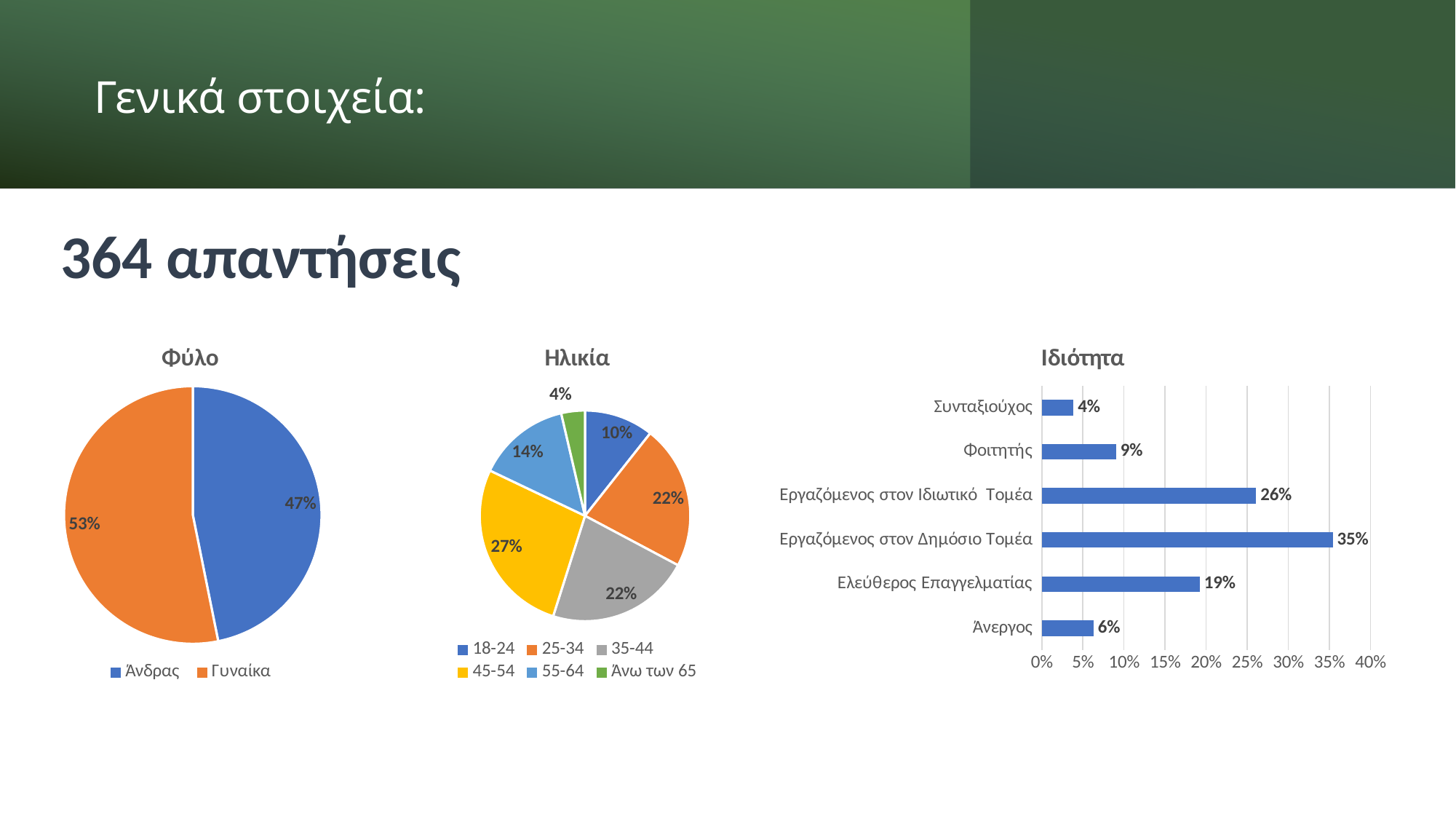
In the 'Φύλο' pie chart, which category has the larger share, Άνδρας or Γυναίκα? Γυναίκα In the 'Ιδιότητα' chart, what is the value for Εργαζόμενος στον Δημόσιο Τομέα? 35% In the 'Ηλικία' pie chart, which age group has the smallest share? Άνω των 65 In the 'Ιδιότητα' chart, how many categories are shown? 6 What kind of chart is the 'Ιδιότητα' chart? Bar chart In the 'Φύλο' pie chart, what share is labelled for Γυναίκα? 53% In the 'Ηλικία' pie chart, what is the difference in percentage points between the 45-54 and 18-24 shares? 17 In the 'Ηλικία' pie chart, how many age groups does the legend list? 6 In the 'Ιδιότητα' chart, which category has the lowest value? Συνταξιούχος In the 'Ηλικία' pie chart, what share is labelled for the 45-54 group? 27% In the 'Ιδιότητα' chart, what is the difference in percentage points between Εργαζόμενος στον Ιδιωτικό Τομέα and Ελεύθερος Επαγγελματίας? 7 In the 'Φύλο' pie chart, what share is labelled for Άνδρας? 47%